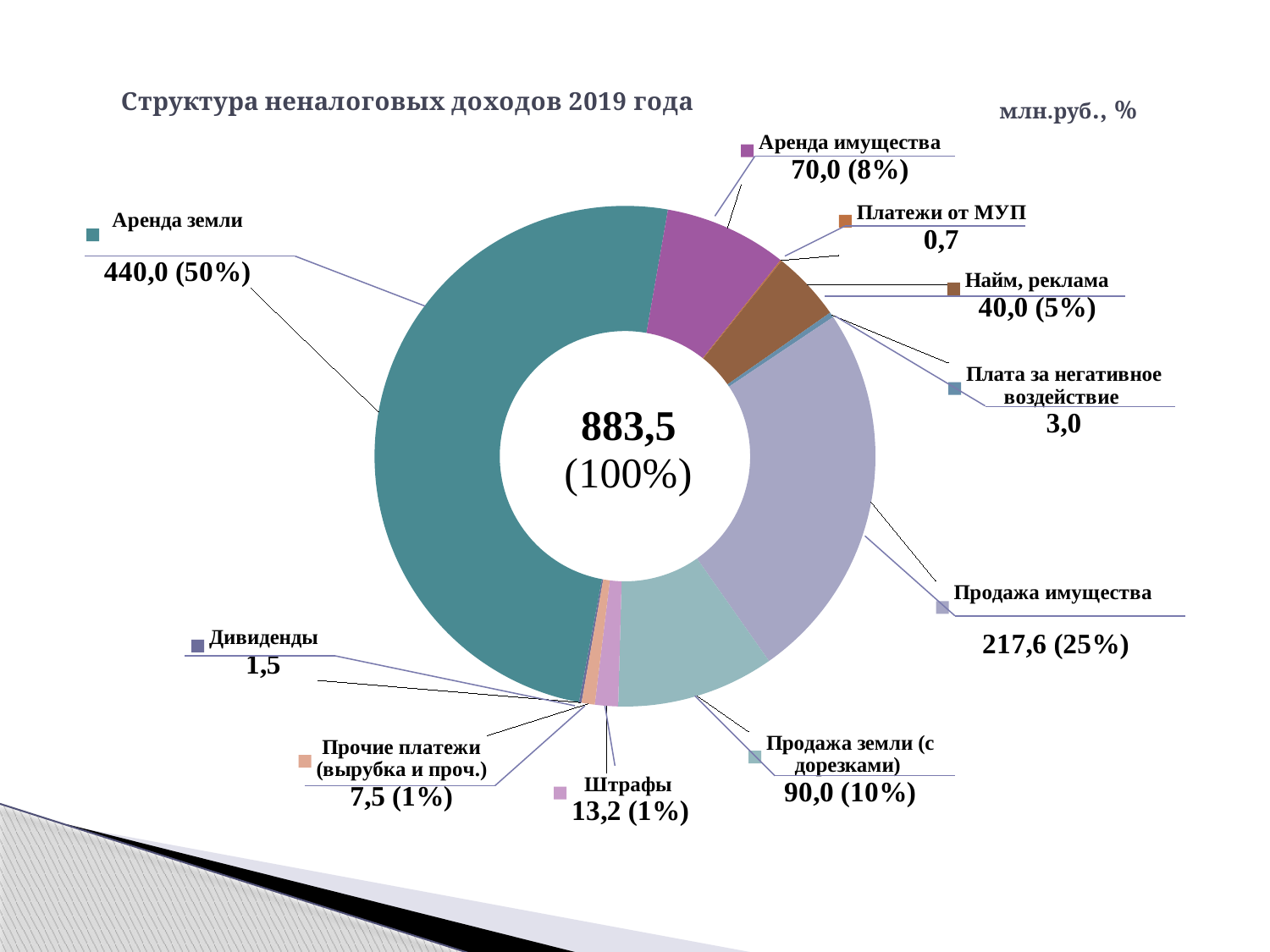
What is the value shown for Штрафы? 13,2 (1%) Which category has the largest share of the chart? Аренда земли What is the value shown for Аренда земли? 440,0 (50%) How many categories are shown on the chart? 10 What share of the chart does Продажа земли (с дорезками) represent? 10% What is the title of the chart? Структура неналоговых доходов 2019 года What is the value shown for Платежи от МУП? 0,7 What type of chart is shown on the slide? Doughnut (pie) chart Which is larger: Аренда имущества or Найм, реклама? Аренда имущества What is the total value shown in the centre of the chart? 883,5 (100%) What is the value shown for Продажа имущества? 217,6 (25%) Which category has the smallest value on the chart? Платежи от МУП